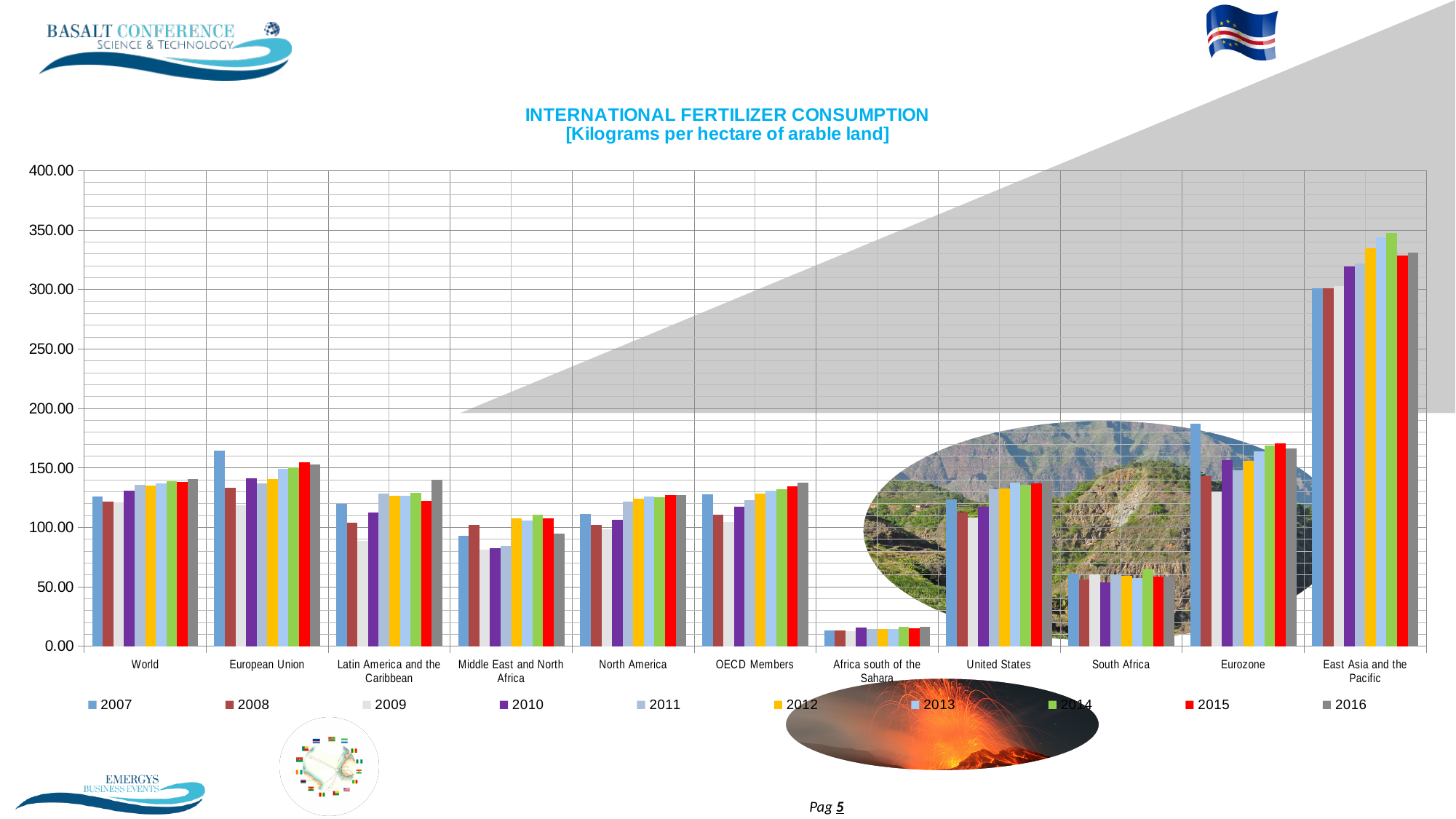
Which category has the highest fertilizer consumption overall? East Asia and the Pacific Which category has the lowest fertilizer consumption overall? Africa south of the Sahara How many categories (regions/countries) are shown on the x axis? 11 Do the bars for East Asia and the Pacific rise or fall from 2007 to 2014? rise What kind of chart is shown on the slide? bar chart Is the value for South Africa in 2008 greater or less than 100? less How many series does the legend list? 10 Is the value for the European Union in 2007 greater or less than 150? greater Which is larger for the Eurozone: the 2007 value or the 2008 value? 2007 What unit is given in the chart title? Kilograms per hectare of arable land Is the value for East Asia and the Pacific in 2014 greater or less than 300? greater Which year has the highest value for the Eurozone? 2007